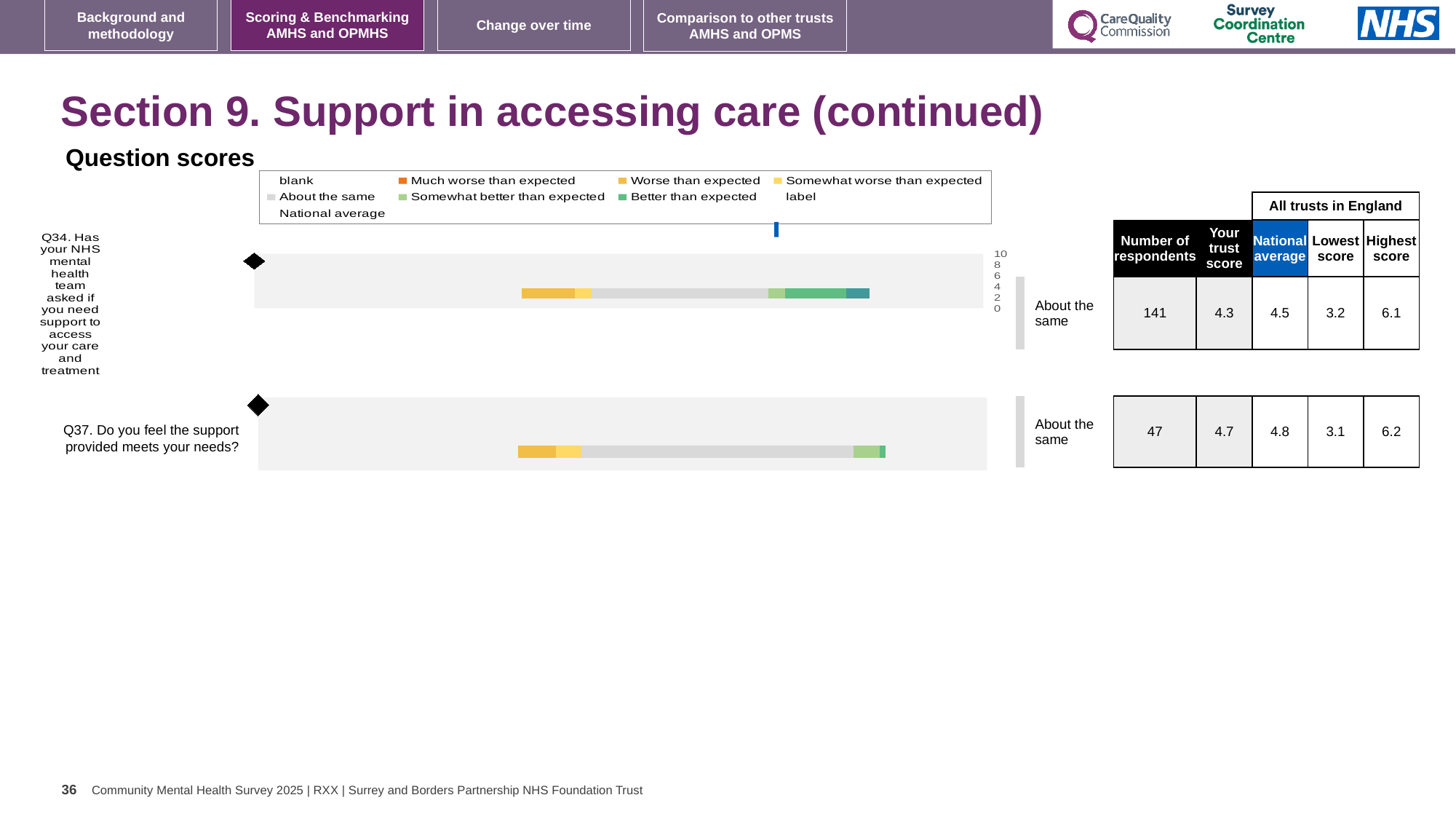
In the question scores chart legend, what colour represents 'Much worse than expected'? orange How many questions are plotted in the question scores chart? 2 How many respondents answered Q37 in the question scores chart? 47 What kind of chart is used to show the question scores for Q34 and Q37? bar chart In the question scores chart, what is the trust score for Q34 (Has your NHS mental health team asked if you need support to access your care and treatment)? 4.3 What is the national average score for Q34 in the question scores chart? 4.5 In the question scores chart, what category is Q34 placed in relative to expectations? About the same In the question scores chart, what is the trust score for Q37 (Do you feel the support provided meets your needs)? 4.7 What is the difference between the highest score and the lowest score for Q34 in the question scores chart? 2.9 What is the highest score among all trusts in England for Q37? 6.2 Which question has the higher trust score in the question scores chart, Q34 or Q37? Q37 By how much does the national average exceed the trust score for Q37 in the question scores chart? 0.1